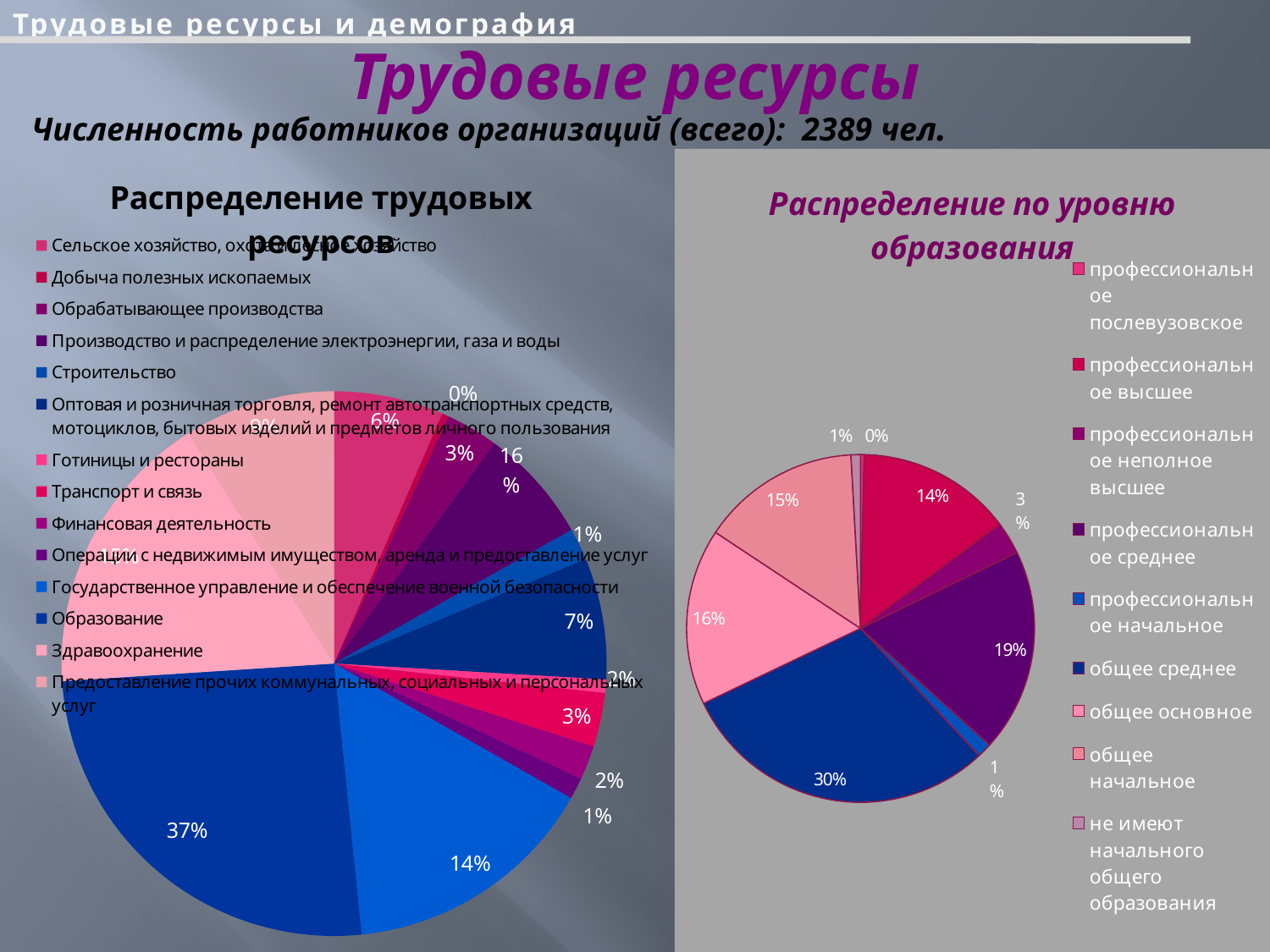
How many categories does the legend of the right pie chart "Распределение по уровню образования" list? 9 How many categories does the legend of the left pie chart "Распределение трудовых ресурсов" list? 14 In the left pie chart "Распределение трудовых ресурсов", what share does Государственное управление и обеспечение военной безопасности have? 14% In the right pie chart "Распределение по уровню образования", what share does профессиональное высшее have? 14% In the right pie chart "Распределение по уровню образования", which category has the largest share? общее среднее In the right pie chart "Распределение по уровню образования", what share does профессиональное среднее have? 19% In the left pie chart "Распределение трудовых ресурсов", which category has the largest share? Образование What type of chart is used for "Распределение трудовых ресурсов" on the left of the slide? pie chart In the right pie chart "Распределение по уровню образования", what is the difference between the shares of общее среднее and профессиональное среднее? 11% In the right pie chart "Распределение по уровню образования", what share does общее среднее have? 30% In the left pie chart "Распределение трудовых ресурсов", what share does Образование have? 37% In the left pie chart "Распределение трудовых ресурсов", what share does Производство и распределение электроэнергии, газа и воды have? 16%